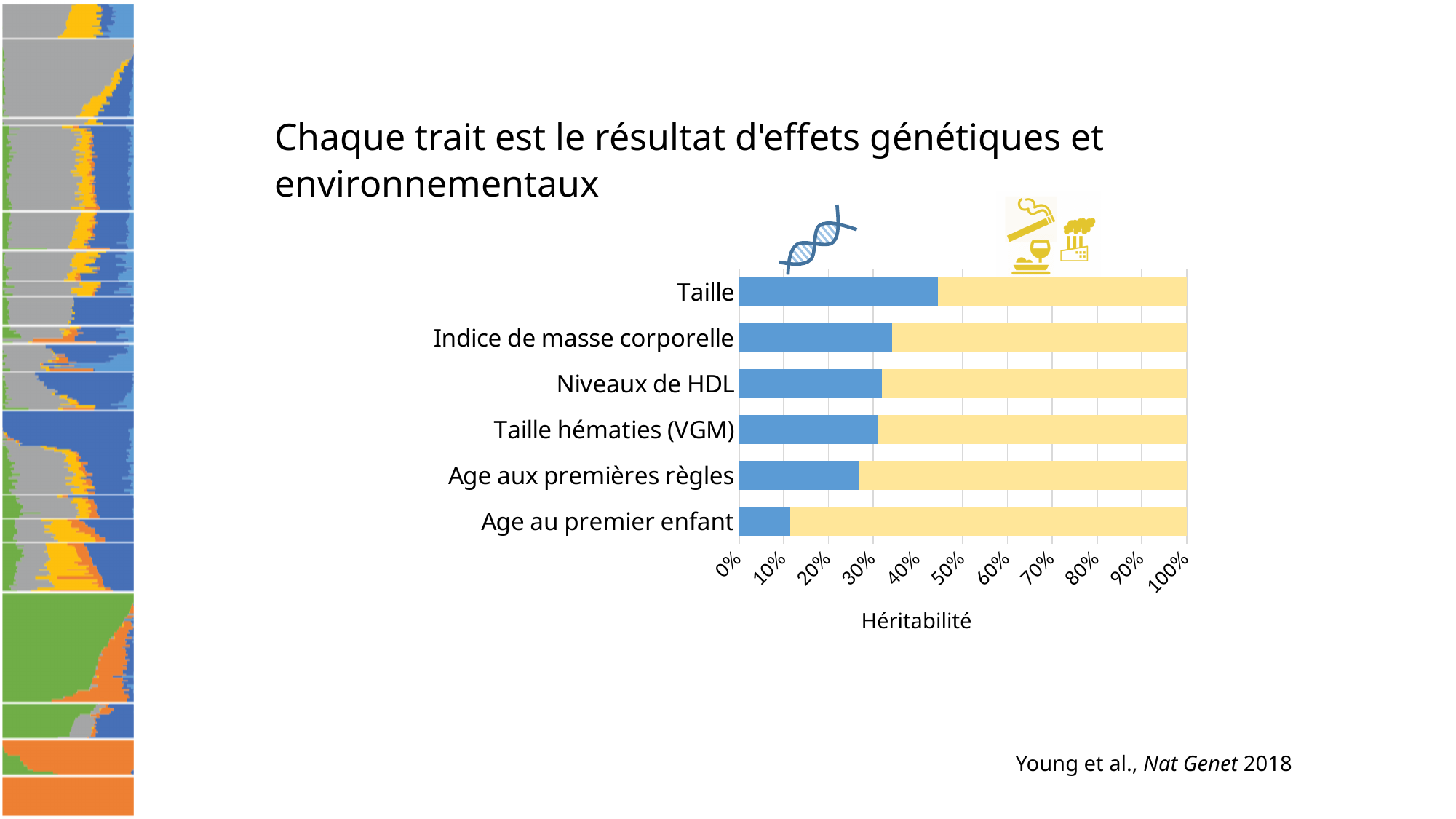
What kind of chart is shown on the slide? bar chart Which has the larger heritability, Age aux premières règles or Age au premier enfant? Age aux premières règles Which trait has the lowest heritability (shortest blue bar)? Age au premier enfant Which trait has the highest heritability (longest blue bar)? Taille Is the heritability value for Age au premier enfant greater or less than 20%? less Is the heritability value for Indice de masse corporelle greater or less than 30%? greater How many traits (categories) are plotted in the chart? 6 Is the heritability value for Taille greater or less than 40%? greater What is the title of the x axis of the chart? Héritabilité Which has the larger heritability, Taille or Indice de masse corporelle? Taille What is the total length of each stacked bar (blue plus yellow) on the x axis? 100%